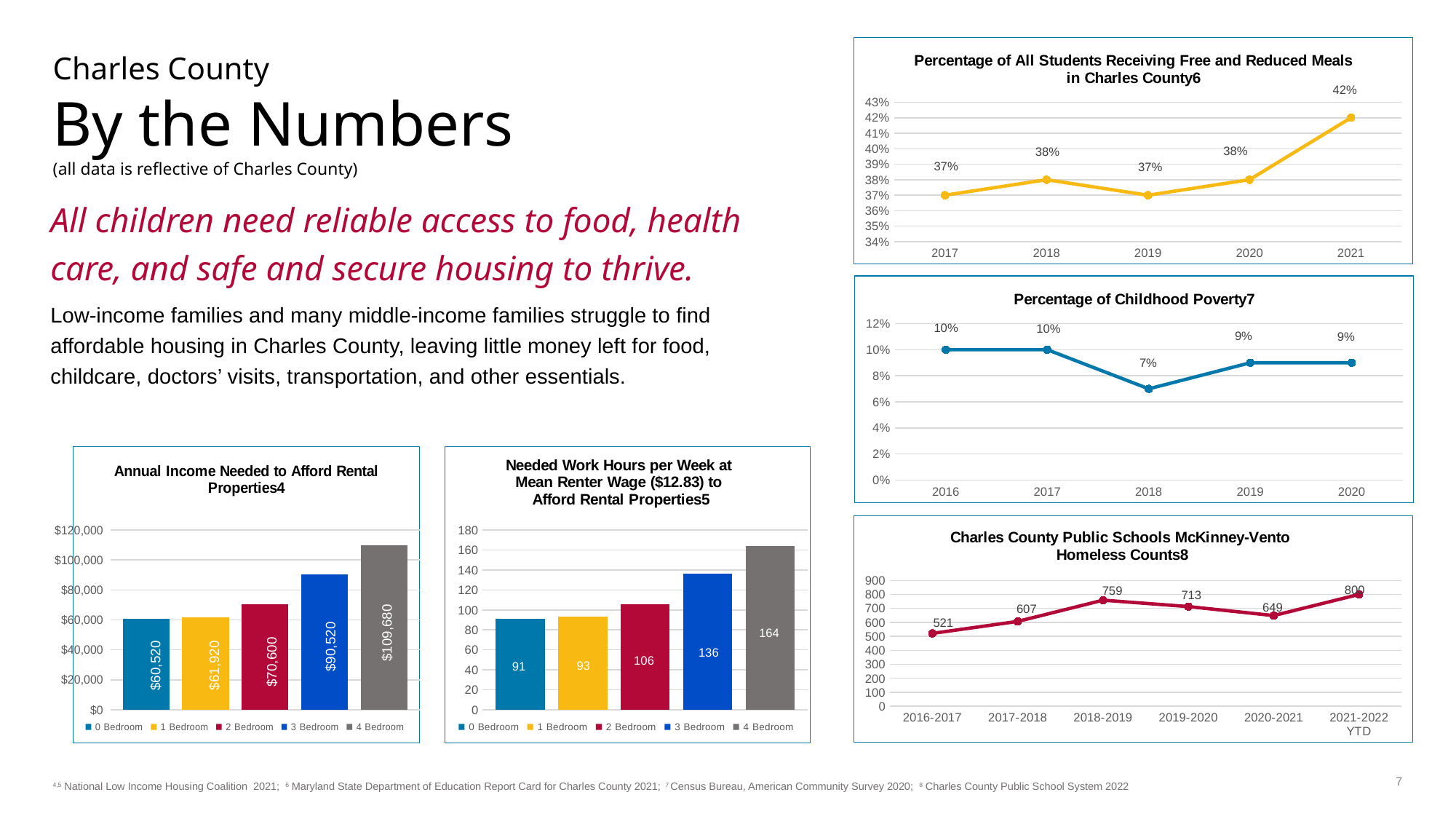
In the 'Percentage of All Students Receiving Free and Reduced Meals' chart, how many years are plotted? 5 In the 'Charles County Public Schools McKinney-Vento Homeless Counts' chart, which is larger, the count for 2018-2019 or 2020-2021? 2018-2019 In the 'Annual Income Needed to Afford Rental Properties' chart, which bedroom category requires the highest annual income? 4 Bedroom What kind of chart is the 'Needed Work Hours per Week' chart? Bar chart In the 'Needed Work Hours per Week' chart, how many work hours per week are needed for a 3 Bedroom? 136 In the 'Percentage of Childhood Poverty' chart, which year had the lowest percentage? 2018 In the 'Annual Income Needed to Afford Rental Properties' chart, what is the difference between the income needed for a 4 Bedroom and a 0 Bedroom? $49,160 In the 'Needed Work Hours per Week' chart, which bedroom category requires the fewest work hours? 0 Bedroom In the 'Annual Income Needed to Afford Rental Properties' chart, what is the annual income needed for a 2 Bedroom? $70,600 In the 'Needed Work Hours per Week' chart, how many series does the legend list? 5 In the 'Charles County Public Schools McKinney-Vento Homeless Counts' chart, what was the count for 2019-2020? 713 In the 'Percentage of All Students Receiving Free and Reduced Meals' chart, what was the percentage in 2021? 42%